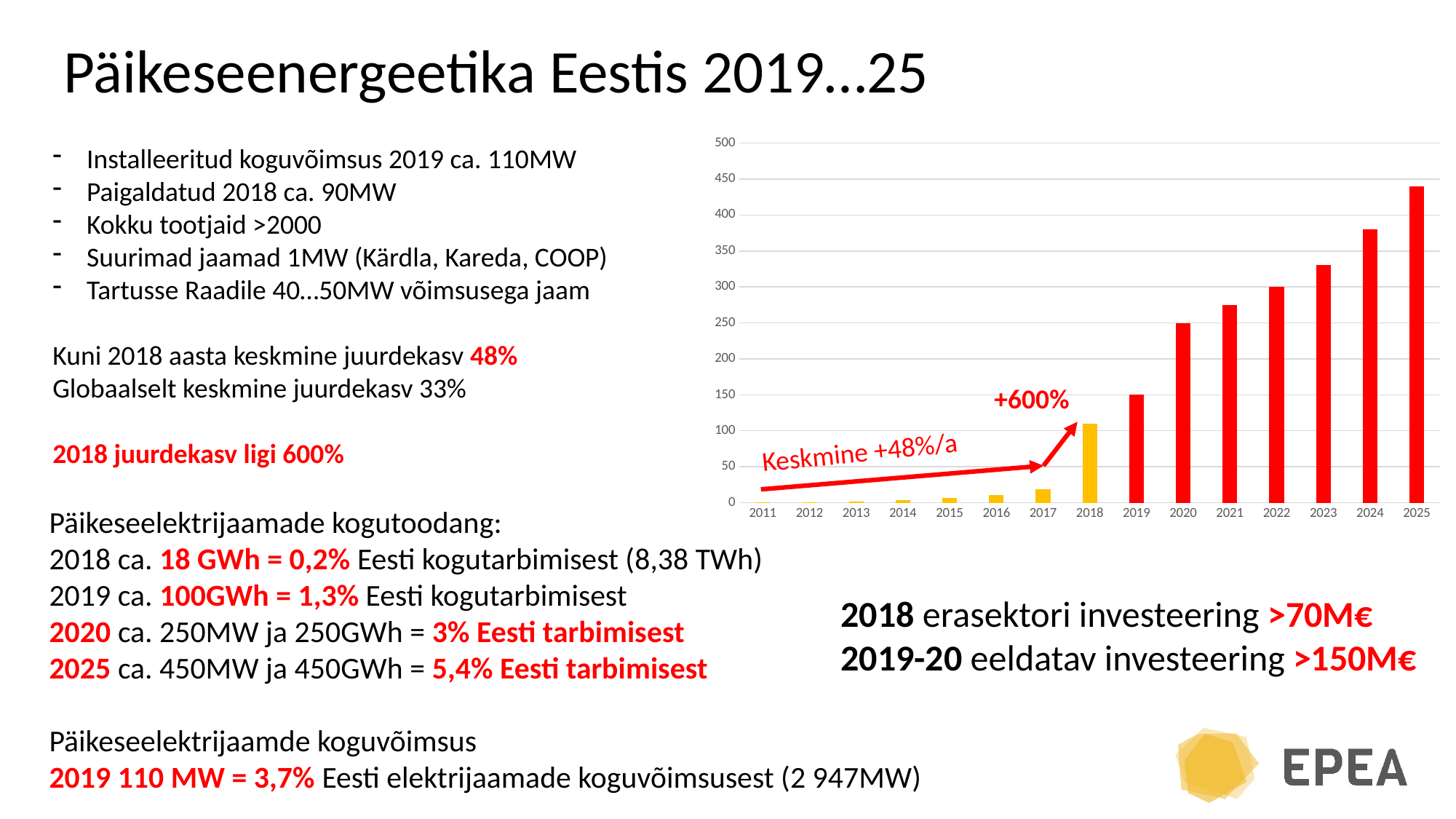
Is the value for 2018 greater or less than 100? greater Which year has the tallest bar in the chart? 2025 Is the value for 2024 greater or less than 400? less What kind of chart is shown on the slide? bar chart What average growth rate is written along the arrow over the 2011–2017 bars? Keskmine +48%/a Which year has the smallest bar in the chart? 2011 Do the bar values rise or fall from 2011 to 2025? rise What percentage growth is annotated next to the 2018 bar in the chart? +600% Is the value for 2017 greater or less than 50? less How many years are shown on the x axis of the chart? 15 Which bar is taller, 2023 or 2024? 2024